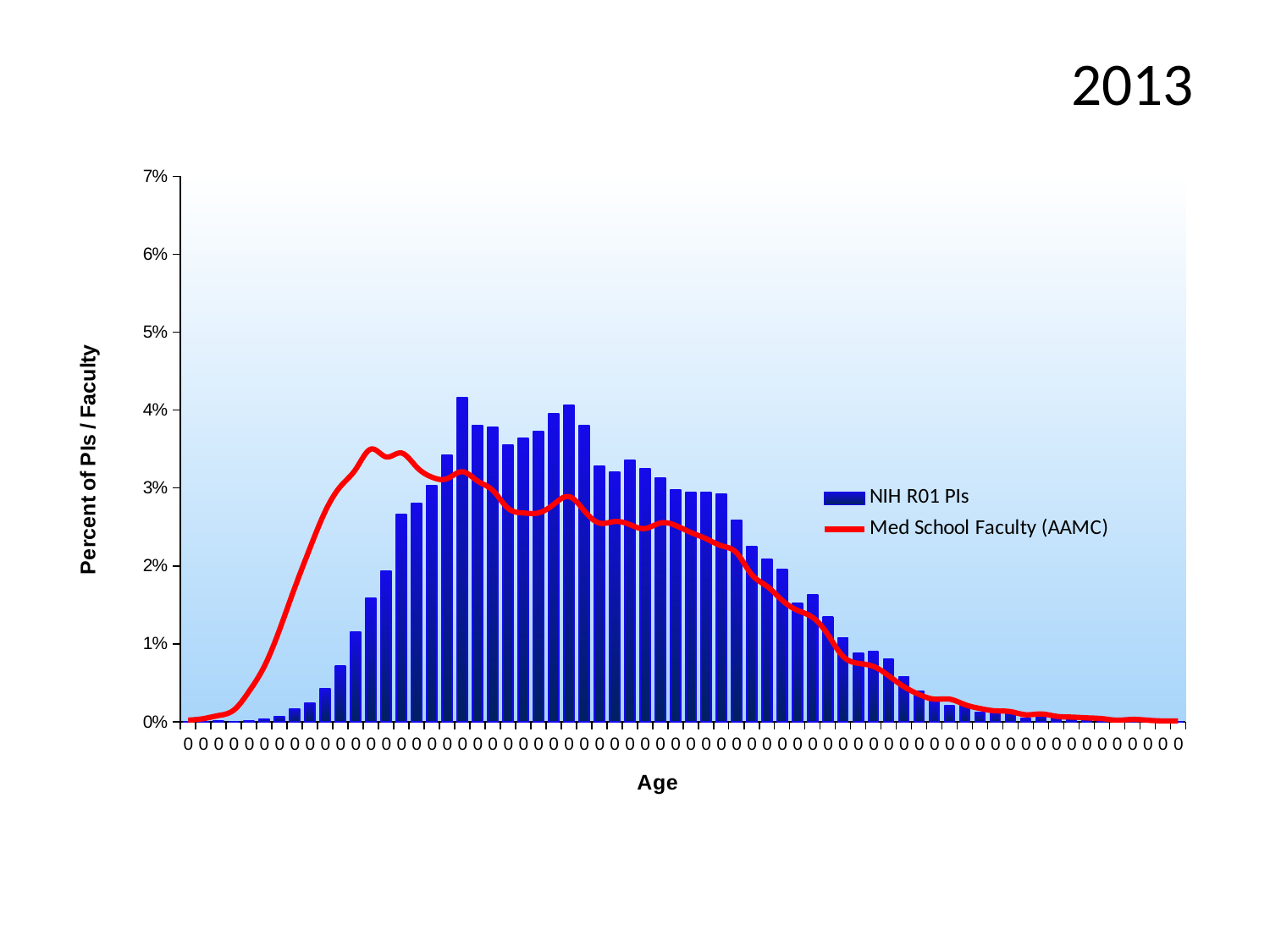
Is the peak of the Med School Faculty (AAMC) line greater or less than 3%? greater Is the tallest NIH R01 PIs bar greater or less than 4%? greater Which series reaches a higher peak value, NIH R01 PIs or Med School Faculty (AAMC)? NIH R01 PIs Is the tallest NIH R01 PIs bar greater or less than 5%? less What year is shown at the top of the slide? 2013 What are the two entries in the legend? NIH R01 PIs; Med School Faculty (AAMC) What kind of chart is this? Bar chart with a line series How many series does the legend list? 2